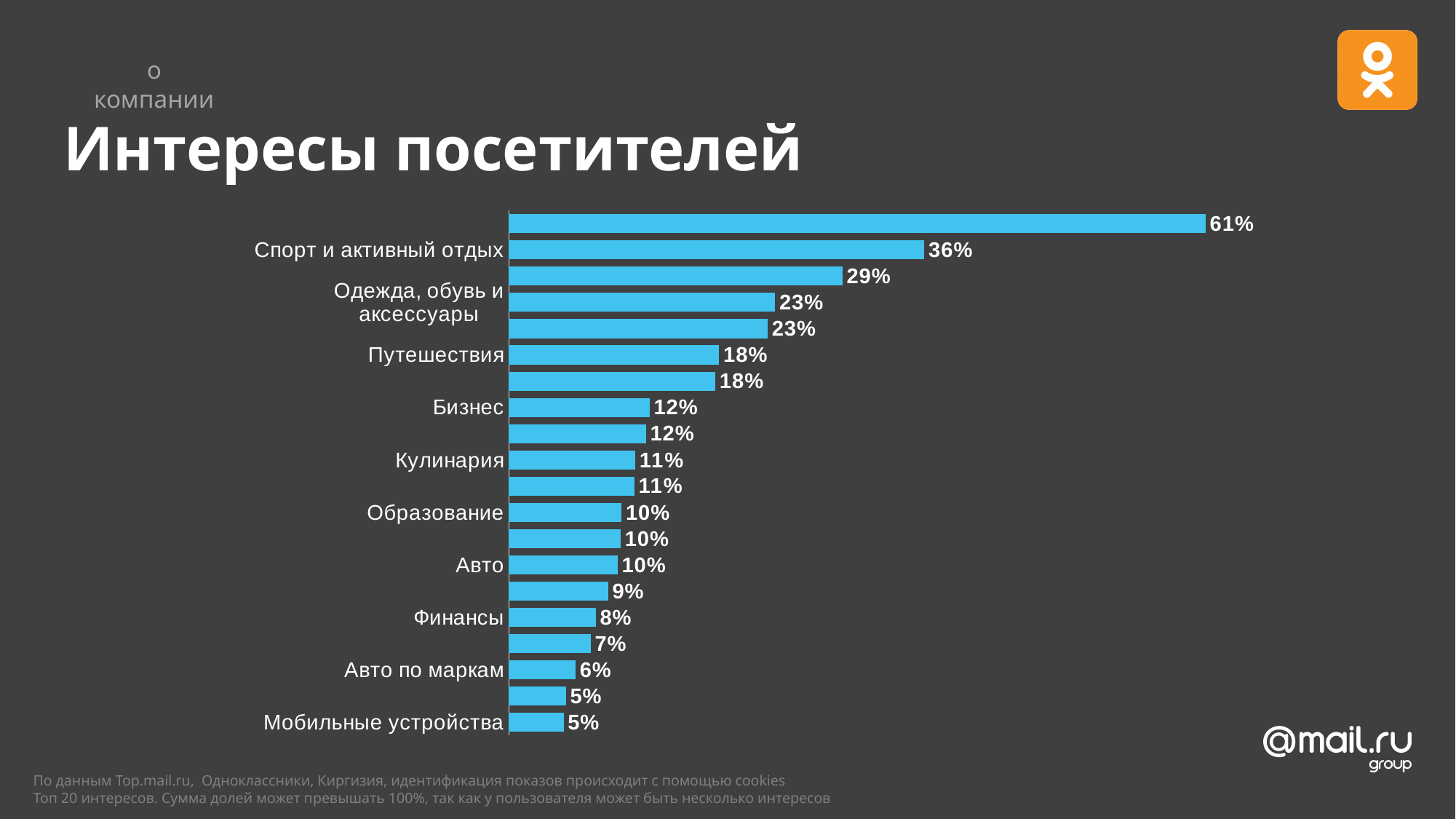
Which is larger, the value for Кулинария or the value for Авто по маркам? Кулинария What is the value for Финансы? 8% What kind of chart is shown on the slide? Bar chart What is the value for Спорт и активный отдых? 36% What is the largest value shown on the chart? 61% What is the title of the slide? Интересы посетителей What is the value for Одежда, обувь и аксессуары? 23% What is the value for Бизнес? 12% What is the value for Мобильные устройства? 5% How many bars are plotted on the chart? 20 What is the value for Путешествия? 18% What is the difference between the values for Спорт и активный отдых and Путешествия? 18%